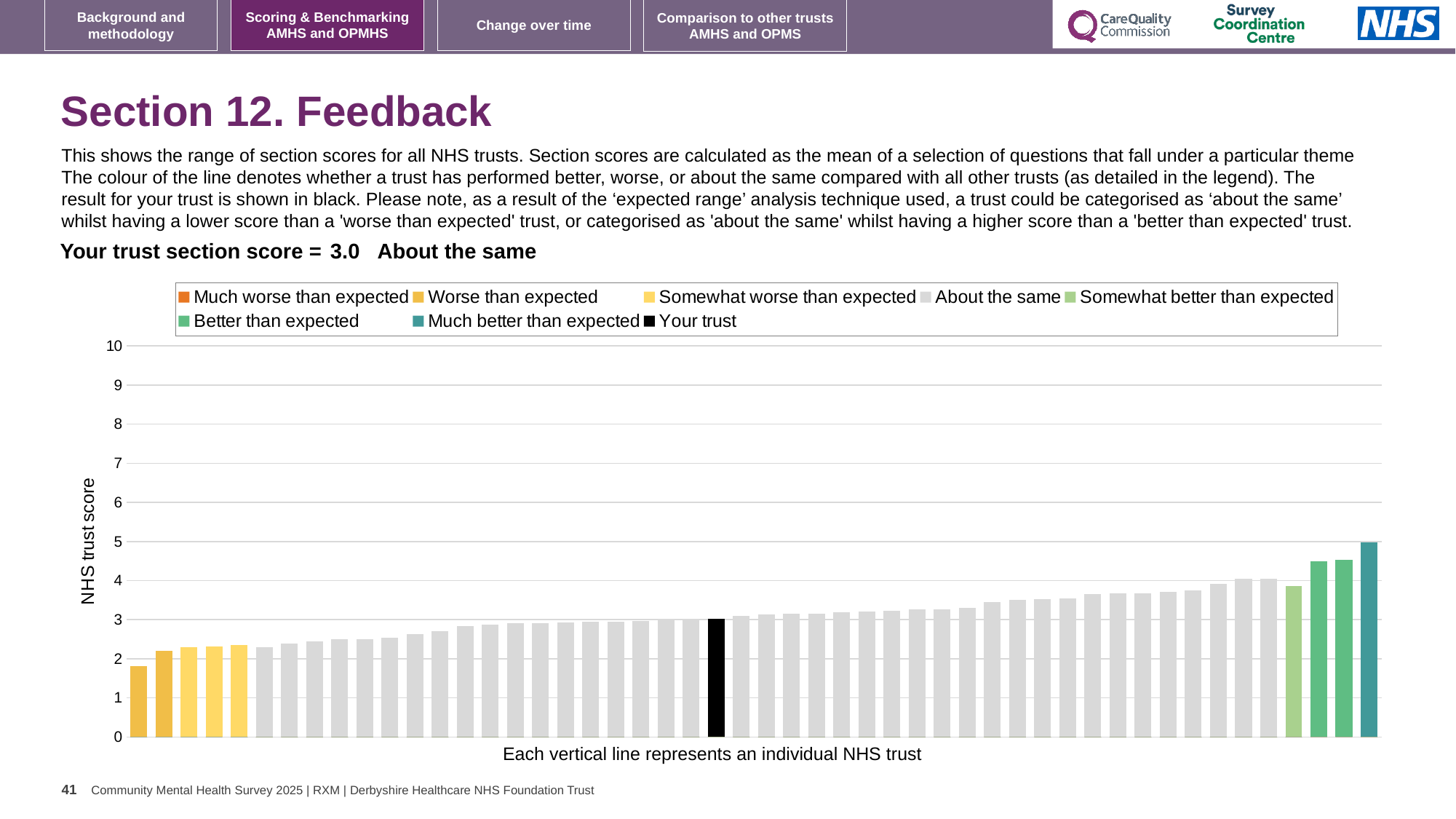
Which legend category does the tallest bar on the right of the chart belong to? Much better than expected Is the value for your trust (the black bar) greater or less than 4? less What is the label on the vertical axis of the chart? NHS trust score Which benchmarking category is your trust placed in for Section 12. Feedback? About the same How many entries does the chart legend list? 8 Do the bar values rise or fall from left to right along the x axis? rise Is the value for your trust (the black bar) greater or less than 2? greater What is the section score for your trust, as stated on the slide? 3.0 According to the x-axis label, what does each vertical line in the chart represent? An individual NHS trust What kind of chart is shown on the slide? bar chart Is the value of the shortest bar in the chart greater or less than 2? less